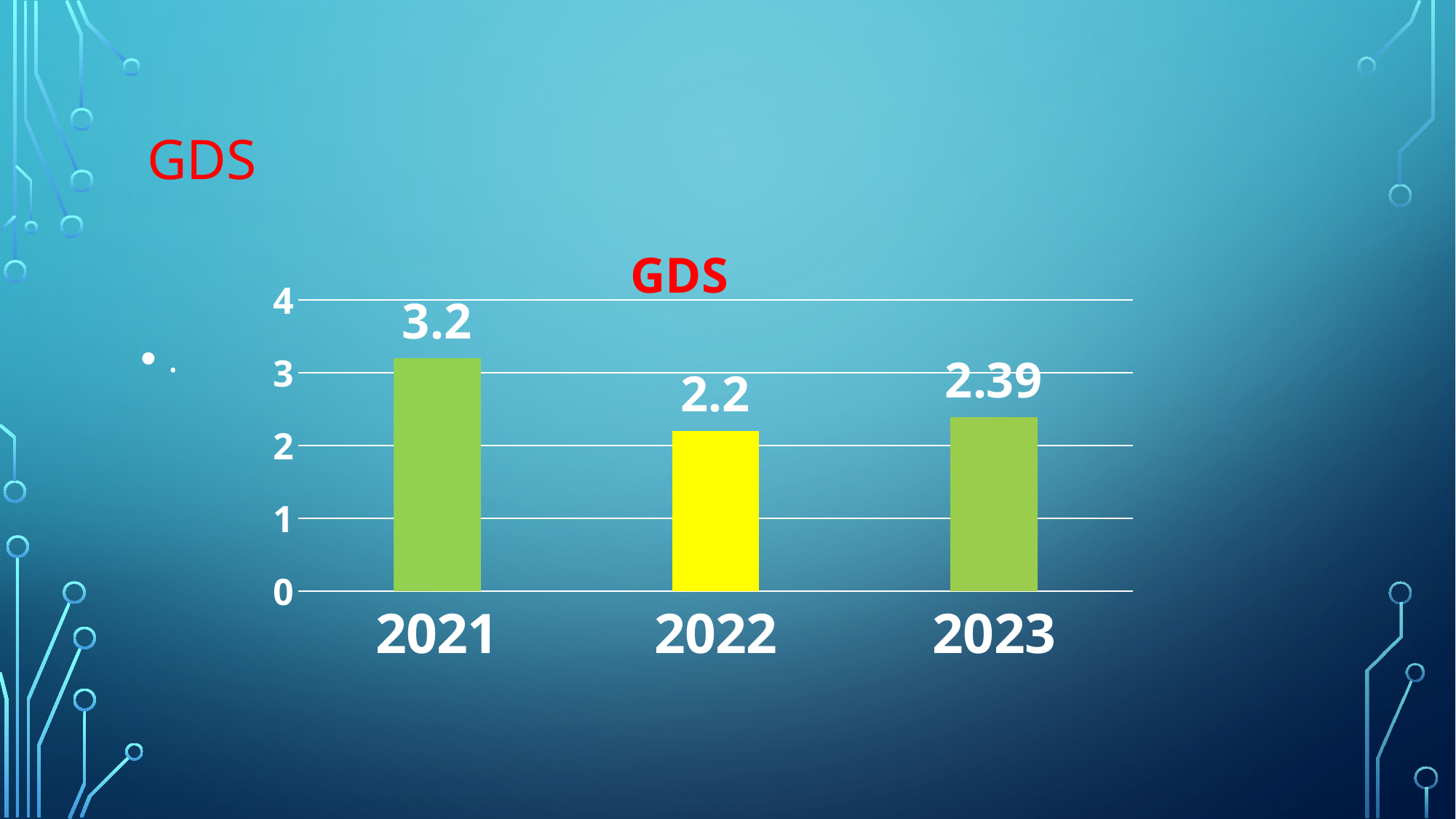
What is the difference between the GDS values for 2023 and 2022? 0.19 What is the GDS value for 2022? 2.2 Which year has a larger GDS value, 2021 or 2023? 2021 Is the GDS value for 2021 greater or less than 3? greater What is the GDS value for 2023? 2.39 Which year has the highest GDS value? 2021 What is the title of the chart? GDS What is the GDS value for 2021? 3.2 How many years are shown on the chart? 3 What is the difference between the GDS values for 2021 and 2022? 1 Which year has the lowest GDS value? 2022 What kind of chart is shown on the slide? Bar chart